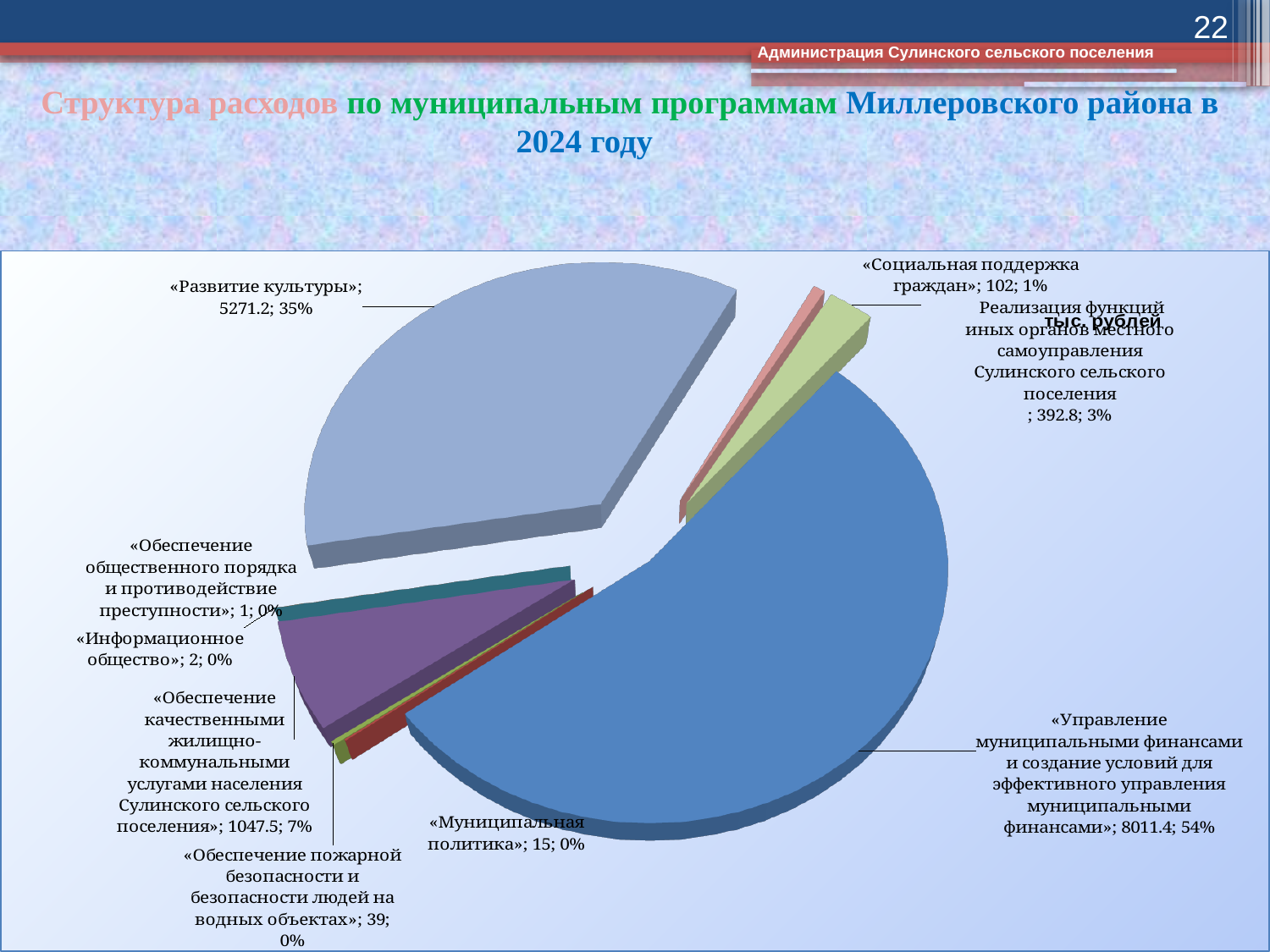
In what units are the values in the chart expressed, according to the label on the slide? тыс. рублей Which is larger: the value for «Обеспечение качественными жилищно-коммунальными услугами...» or for «Реализация функций иных органов местного самоуправления...»? «Обеспечение качественными жилищно-коммунальными услугами...» What is the value shown for «Развитие культуры»? 5271.2 What is the difference between the values for «Управление муниципальными финансами...» (8011.4) and «Развитие культуры» (5271.2)? 2740.2 What share of the pie does «Развитие культуры» represent? 35% What kind of chart is shown on the slide? pie chart What share of the pie does «Управление муниципальными финансами...» represent? 54% Which programme has the smallest value in the pie chart? «Обеспечение общественного порядка и противодействие преступности» What is the value shown for «Социальная поддержка граждан»? 102 How many slices does the pie chart have? 9 What is the value shown for «Обеспечение пожарной безопасности и безопасности людей на водных объектах»? 39 Which programme has the largest share of expenditure in the pie chart? «Управление муниципальными финансами и создание условий для эффективного управления муниципальными финансами»